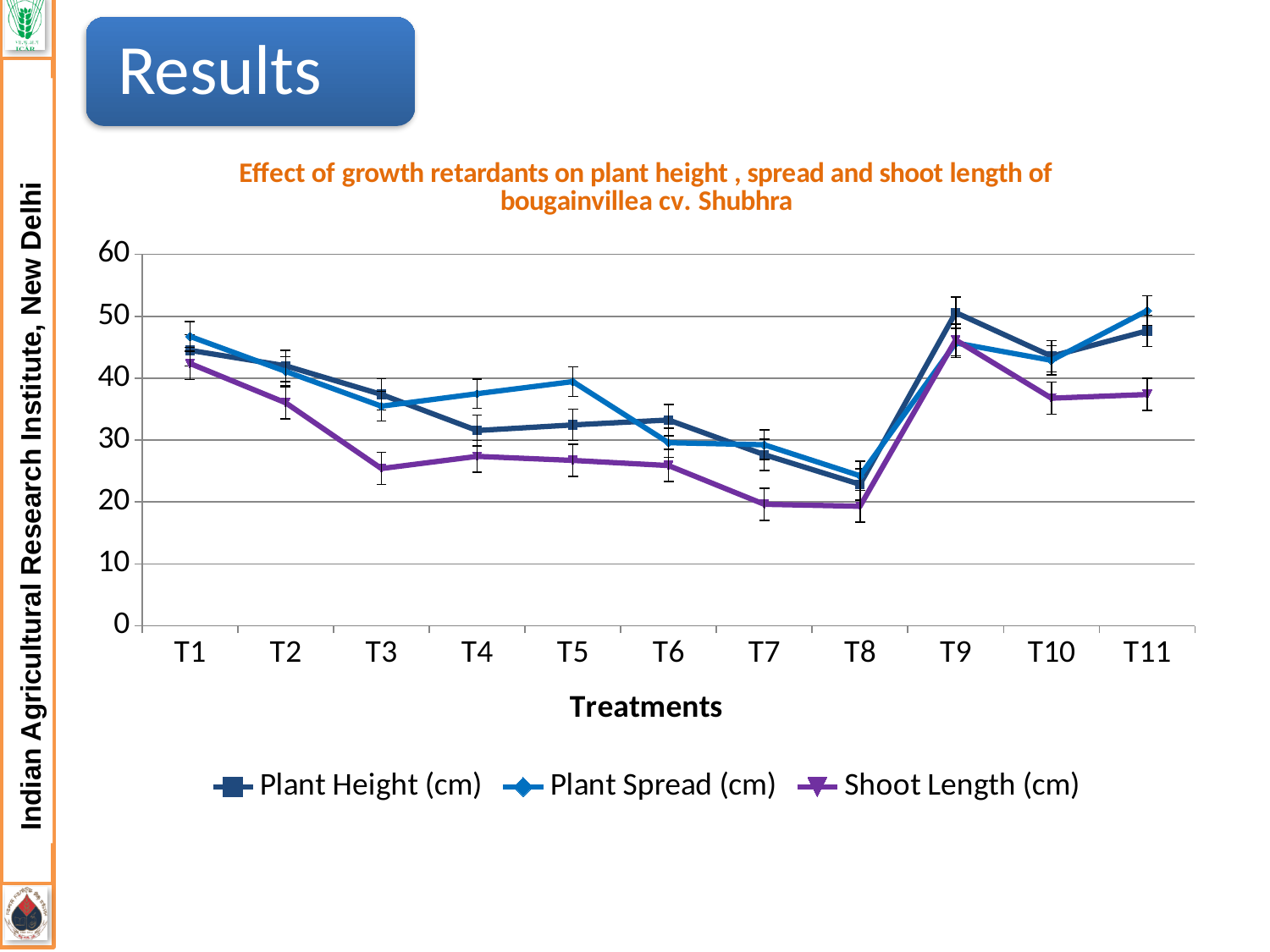
What kind of chart is shown on the slide? Line chart Which treatment has the highest Plant Height (cm)? T9 At T3, which is larger: Plant Height (cm) or Shoot Length (cm)? Plant Height (cm) Is the Plant Height (cm) value for T9 greater or less than 40? greater How many treatments are shown on the x axis? 11 Does Plant Height (cm) rise or fall from T1 to T4? fall Is the Shoot Length (cm) value for T3 greater or less than 30? less At T5, which is larger: Plant Spread (cm) or Plant Height (cm)? Plant Spread (cm) How many series does the legend list? 3 Is the Plant Spread (cm) value for T8 greater or less than 30? less Which treatment has the lowest Plant Height (cm)? T8 What is the title of the x axis? Treatments